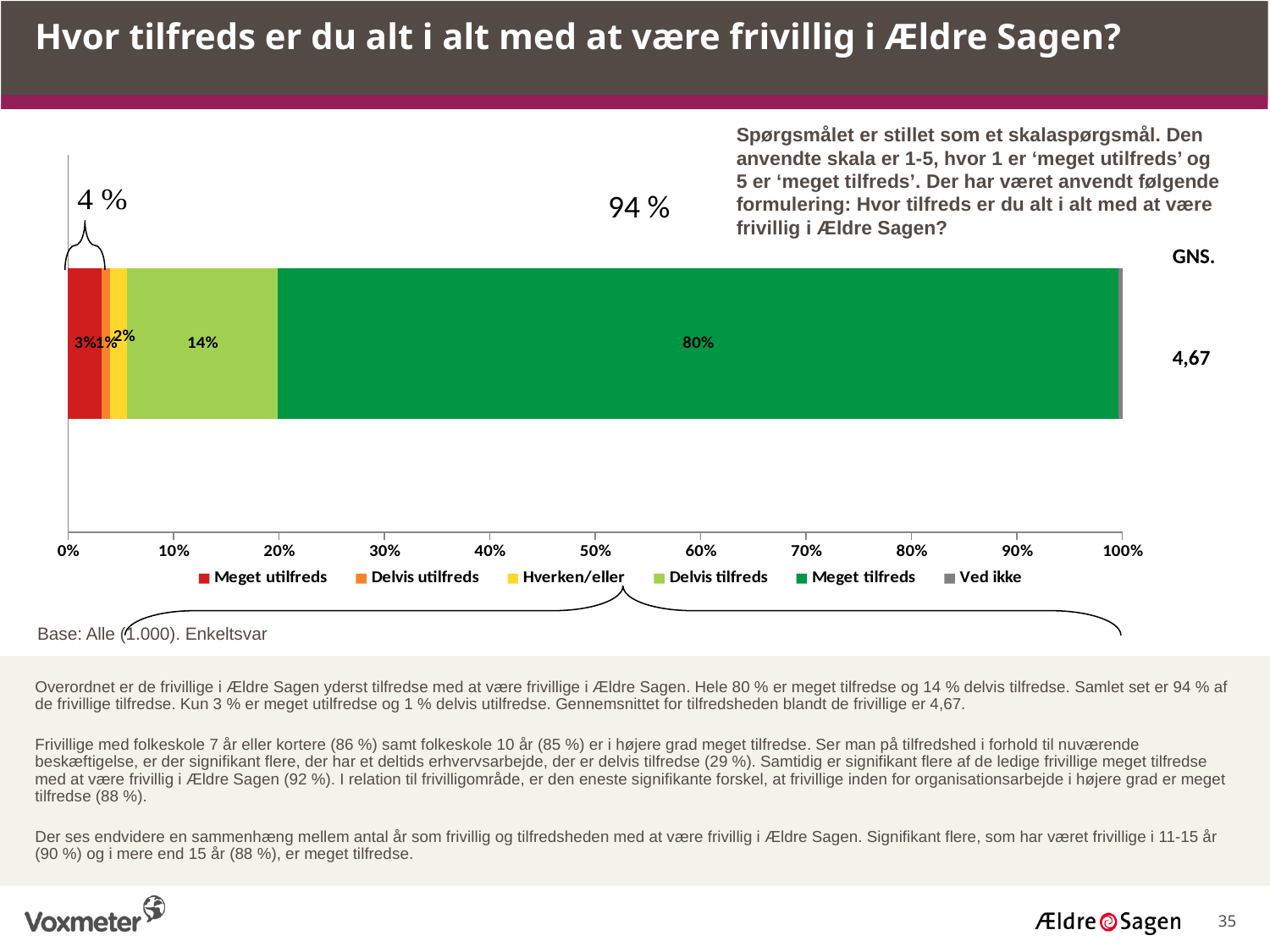
How many series does the legend list? 6 What percentage of respondents answered 'Hverken/eller'? 2% Which response category has the largest share in the bar? Meget tilfreds What percentage of respondents answered 'Meget utilfreds'? 3% What percentage of respondents answered 'Delvis tilfreds'? 14% Which is larger, the share for 'Meget utilfreds' or the share for 'Hverken/eller'? Meget utilfreds Is the value for 'Meget tilfreds' greater or less than 70%? greater What average score (GNS.) is shown next to the bar? 4,67 What kind of chart is shown on the slide? Stacked bar chart What percentage of respondents answered 'Delvis utilfreds'? 1% What is the difference in percentage points between 'Meget tilfreds' and 'Delvis tilfreds'? 66 What percentage of respondents answered 'Meget tilfreds'? 80%